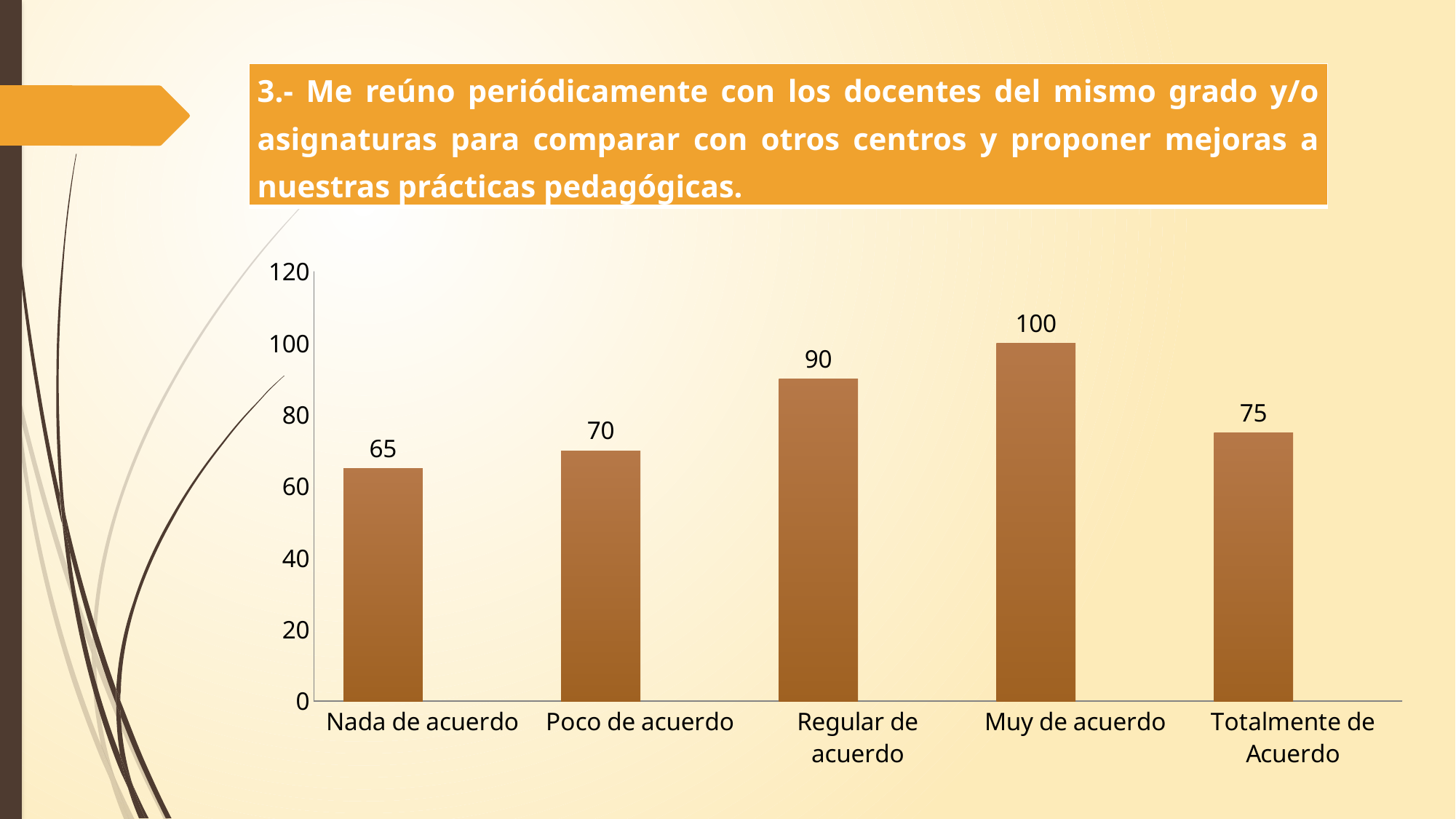
What is the value for Regular de acuerdo? 90 What is the value for Totalmente de Acuerdo? 75 Which category has the highest value? Muy de acuerdo What is the value for Nada de acuerdo? 65 How many categories are shown on the x axis? 5 Which category has the lowest value? Nada de acuerdo What is the difference between the values for Muy de acuerdo and Nada de acuerdo? 35 Is the value for Regular de acuerdo greater or less than 80? greater What kind of chart is shown on the slide? bar chart What is the difference between the values for Regular de acuerdo and Totalmente de Acuerdo? 15 What is the value for Poco de acuerdo? 70 Which is larger, the value for Poco de acuerdo or the value for Totalmente de Acuerdo? Totalmente de Acuerdo